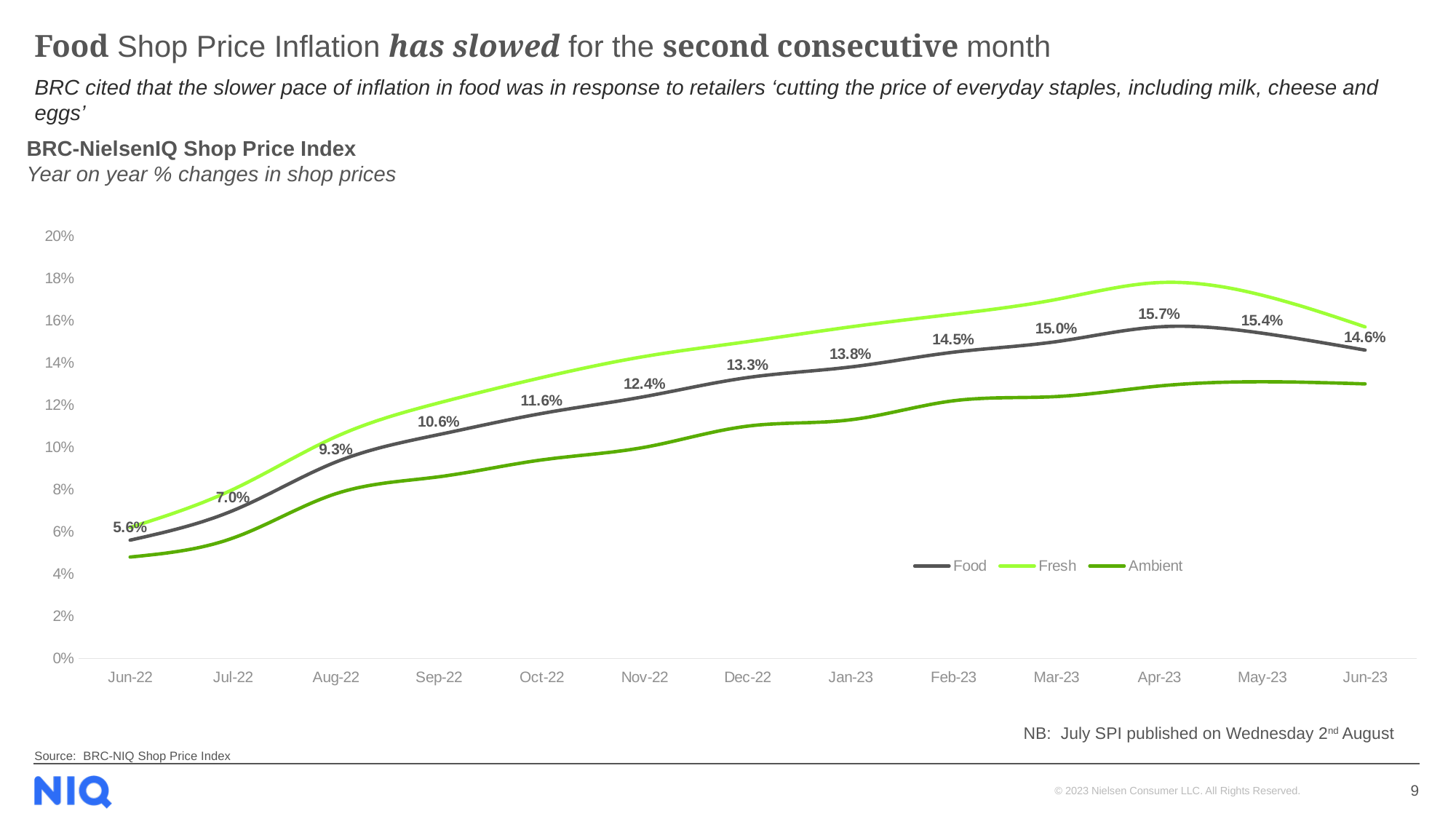
What is the Food value for Jun-23? 14.6% Is the Ambient value for Jun-22 greater or less than 6%? less Is the Fresh value for Apr-23 greater or less than 16%? greater What type of chart is shown on the slide? line chart How many series does the legend list? 3 What is the difference between the Food value in Apr-23 and the Food value in Jun-23? 1.1% What is the Food value for Apr-23? 15.7% How many months are plotted along the x axis? 13 Which is larger, the Food value for Dec-22 or the Food value for Jan-23? Jan-23 What is the Food value for Jun-22? 5.6% In which month is the Food series at its lowest value? Jun-22 In which month does the Food series reach its highest value? Apr-23